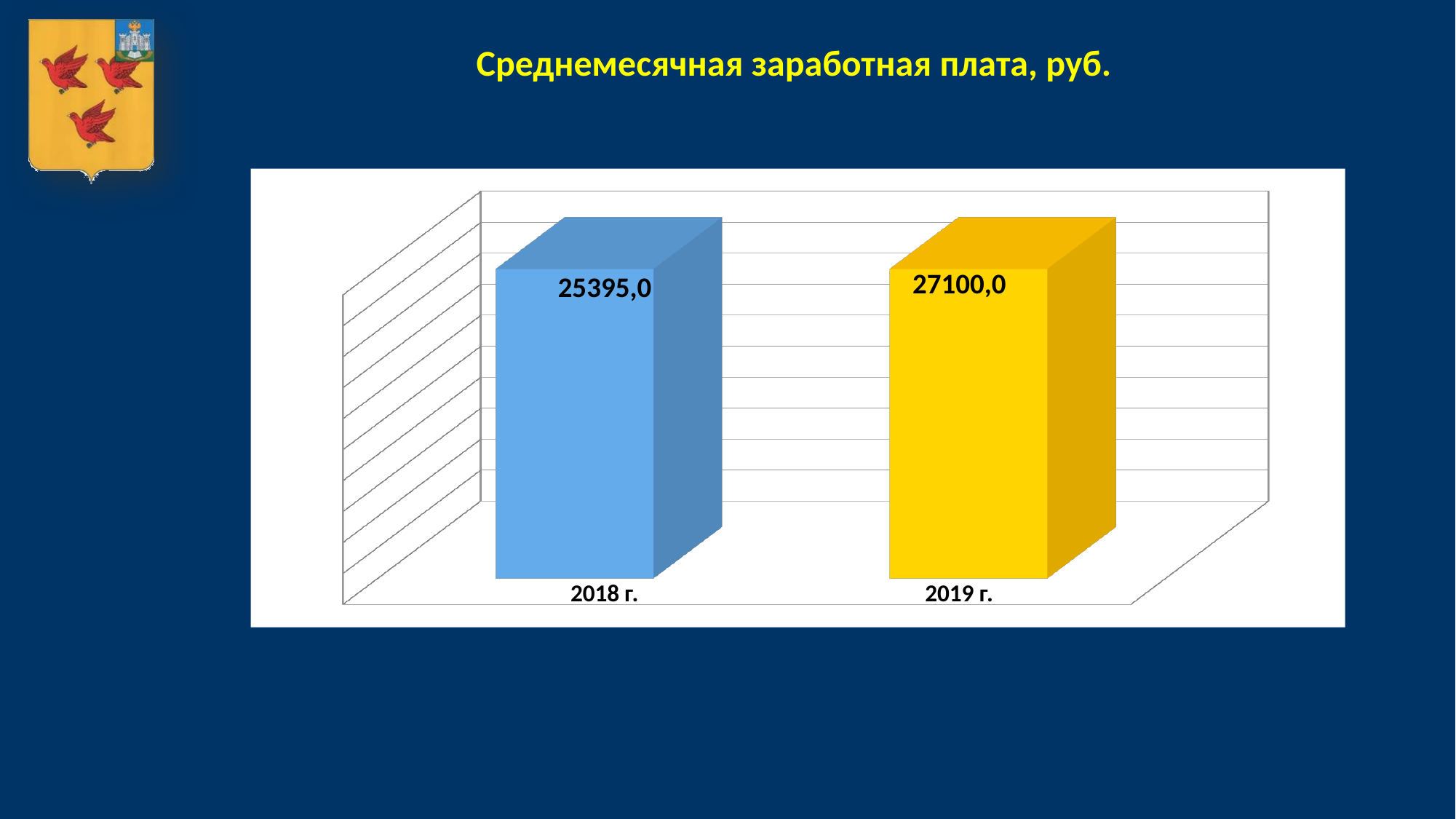
What is the title of the chart on the slide? Среднемесячная заработная плата, руб. What is the average monthly salary shown for 2018 г.? 25395,0 What kind of chart is shown on the slide? bar chart How many years (categories) are shown on the chart? 2 Is the value for 2018 г. larger or smaller than the value for 2019 г.? smaller By how much does the 2019 г. value exceed the 2018 г. value? 1705,0 What colour is the bar for 2019 г.? yellow What is the average monthly salary shown for 2019 г.? 27100,0 Which year has the higher average monthly salary? 2019 г. Which year has the lower average monthly salary? 2018 г. Do the values rise or fall from 2018 г. to 2019 г.? rise